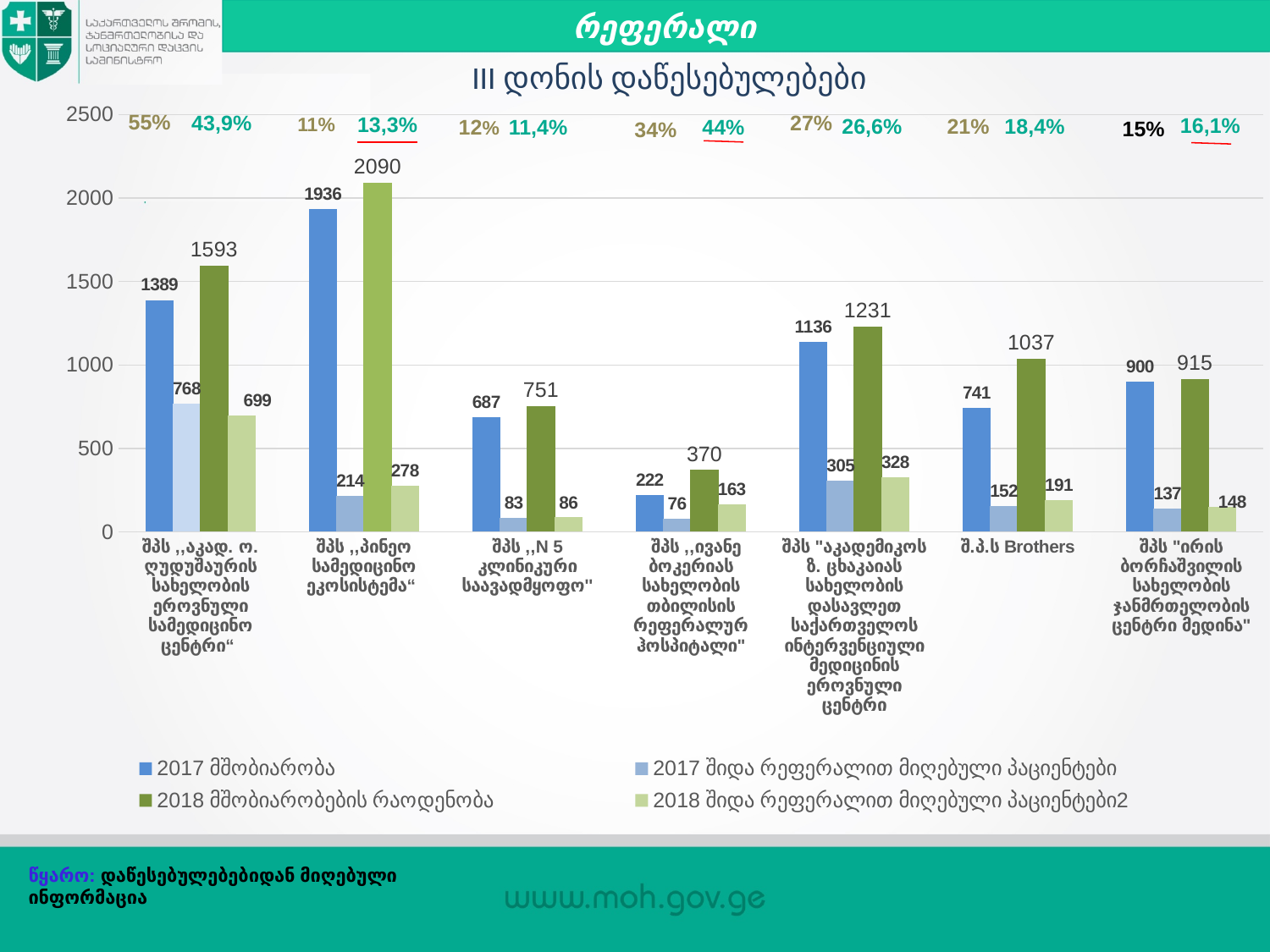
Which is larger for შპს "ირის ბორჩაშვილის სახელობის ჯანმრთელობის ცენტრი მედინა": 2017 შიდა რეფერალით მიღებული პაციენტები or 2018 შიდა რეფერალით მიღებული პაციენტები2? 2018 შიდა რეფერალით მიღებული პაციენტები2 What is the value of 2018 მშობიარობების რაოდენობა for შპს ,,პინეო სამედიცინო ეკოსისტემა"? 2090 Which institution has the highest value for 2018 მშობიარობების რაოდენობა? შპს ,,პინეო სამედიცინო ეკოსისტემა" How many institutions (categories) are shown on the x axis? 7 How many series does the legend list? 4 What is the value of 2017 მშობიარობა for შ.პ.ს Brothers? 741 What is the title of the chart? III დონის დაწესებულებები What type of chart is shown on the slide? bar chart What percentage is printed in green above the bars for შპს ,,ივანე ბოკერიას სახელობის თბილისის რეფერალურ ჰოსპიტალი"? 44% What is the value of 2017 შიდა რეფერალით მიღებული პაციენტები for შპს ,,N 5 კლინიკური საავადმყოფო"? 83 Which institution has the lowest value for 2017 მშობიარობა? შპს ,,ივანე ბოკერიას სახელობის თბილისის რეფერალურ ჰოსპიტალი" What is the difference between the 2018 მშობიარობების რაოდენობა and 2017 მშობიარობა values for შ.პ.ს Brothers? 296